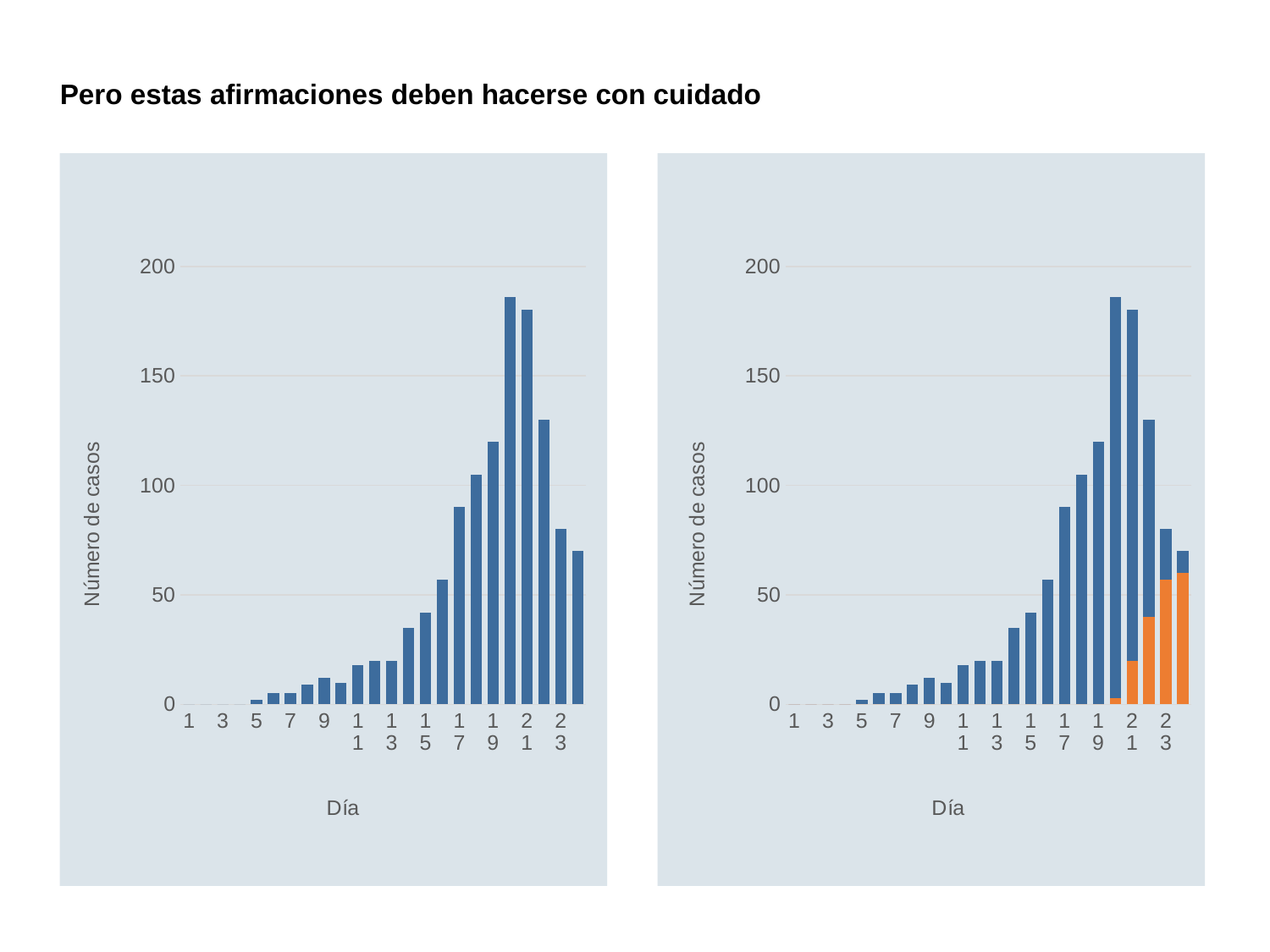
In the left chart, is the value for day 20 greater or less than 150? greater In the right chart, is the total value for day 24 greater or less than 50? greater What is the x-axis title of the right chart? Día In the right chart, which is larger, the total for day 22 or the total for day 24? day 22 In the left chart, is the value for day 15 greater or less than 50? less What is the y-axis title of the left chart? Número de casos In the left chart, which is larger, the value for day 19 or the value for day 17? day 19 In the left chart, do the values rise or fall from day 5 to day 20? rise What kind of chart is the left chart on the slide? bar chart